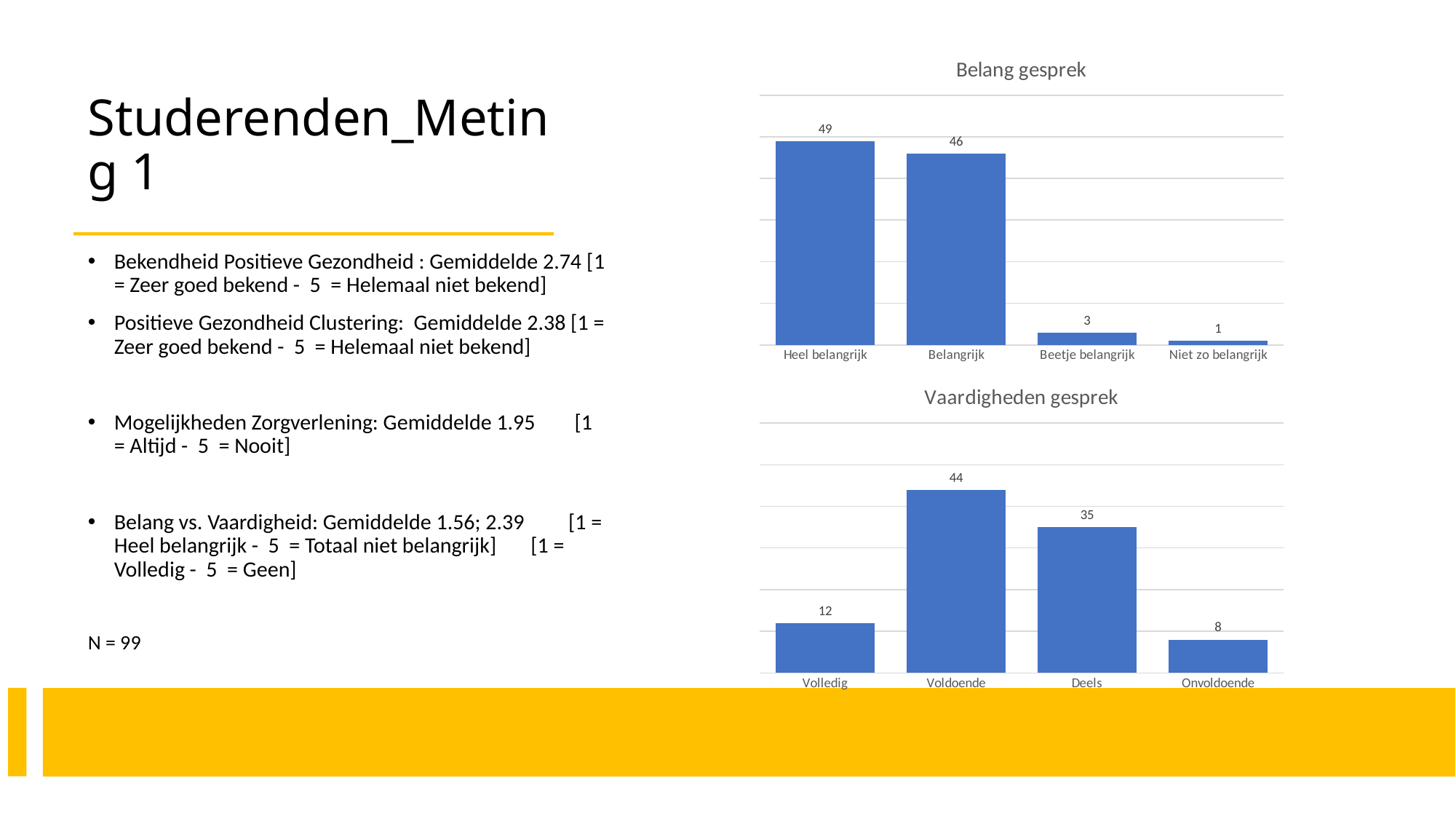
In the 'Vaardigheden gesprek' chart, which category has the highest value? Voldoende In the 'Vaardigheden gesprek' chart, what is the value for 'Onvoldoende'? 8 What kind of chart is the 'Vaardigheden gesprek' chart? Bar chart In the 'Belang gesprek' chart, which category has the lowest value? Niet zo belangrijk In the 'Belang gesprek' chart, what is the value for 'Heel belangrijk'? 49 In the 'Vaardigheden gesprek' chart, which is larger: 'Volledig' or 'Deels'? Deels What is the title of the top chart on the slide? Belang gesprek In the 'Vaardigheden gesprek' chart, what is the difference between 'Deels' and 'Volledig'? 23 In the 'Belang gesprek' chart, how many categories are shown? 4 In the 'Vaardigheden gesprek' chart, what is the value for 'Voldoende'? 44 In the 'Belang gesprek' chart, what is the value for 'Beetje belangrijk'? 3 In the 'Belang gesprek' chart, what is the difference between 'Heel belangrijk' and 'Belangrijk'? 3